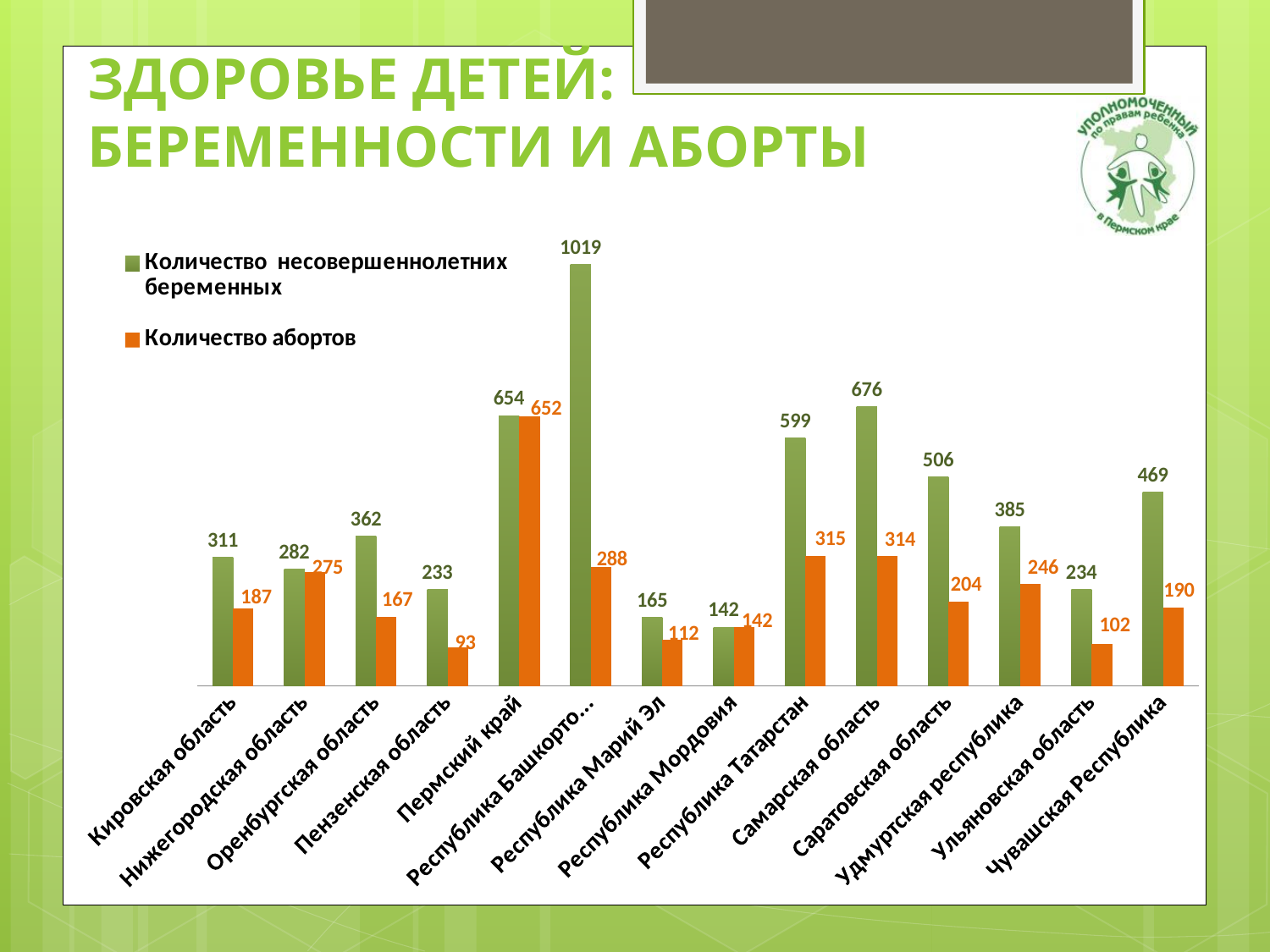
What kind of chart is shown on the slide? bar chart What is the value of 'Количество несовершеннолетних беременных' for Пермский край? 654 What is the value of 'Количество несовершеннолетних беременных' for Чувашская Республика? 469 Which region has the highest value of 'Количество несовершеннолетних беременных'? Республика Башкорто... What is the value of 'Количество абортов' for Пензенская область? 93 What is the difference between 'Количество несовершеннолетних беременных' and 'Количество абортов' for Самарская область? 362 Which region has the lowest value of 'Количество абортов'? Пензенская область What colour are the bars for 'Количество абортов'? orange What is the value of 'Количество абортов' for Республика Татарстан? 315 How many series does the legend list? 2 Which is larger: 'Количество абортов' for Удмуртская республика or for Саратовская область? Удмуртская республика How many regions (categories) are shown on the x axis? 14